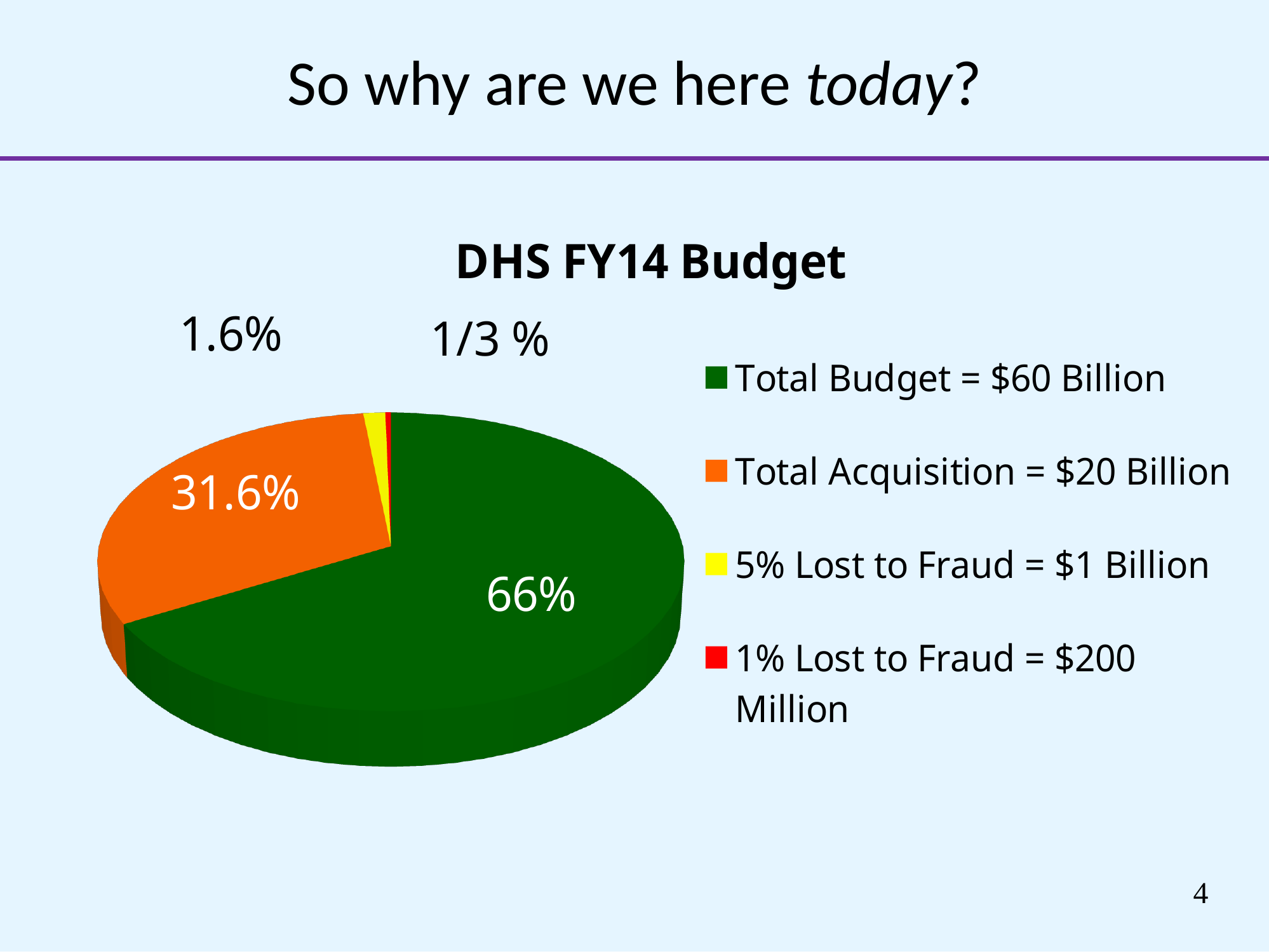
Which legend entry has the largest slice of the pie? Total Budget = $60 Billion What percentage is shown on the Total Acquisition = $20 Billion slice? 31.6% What colour is the Total Acquisition = $20 Billion slice? orange What is the title of the chart? DHS FY14 Budget How many entries does the chart's legend list? 4 What is the difference in percentage points between the Total Budget slice and the Total Acquisition slice? 34.4 What kind of chart is shown on the slide? pie chart What percentage label is shown for the 1% Lost to Fraud = $200 Million slice? 1/3 % Which legend entry has the smallest slice of the pie? 1% Lost to Fraud = $200 Million What percentage label is shown for the 5% Lost to Fraud = $1 Billion slice? 1.6% How many slices does the pie chart have? 4 What percentage is shown on the Total Budget = $60 Billion slice? 66%